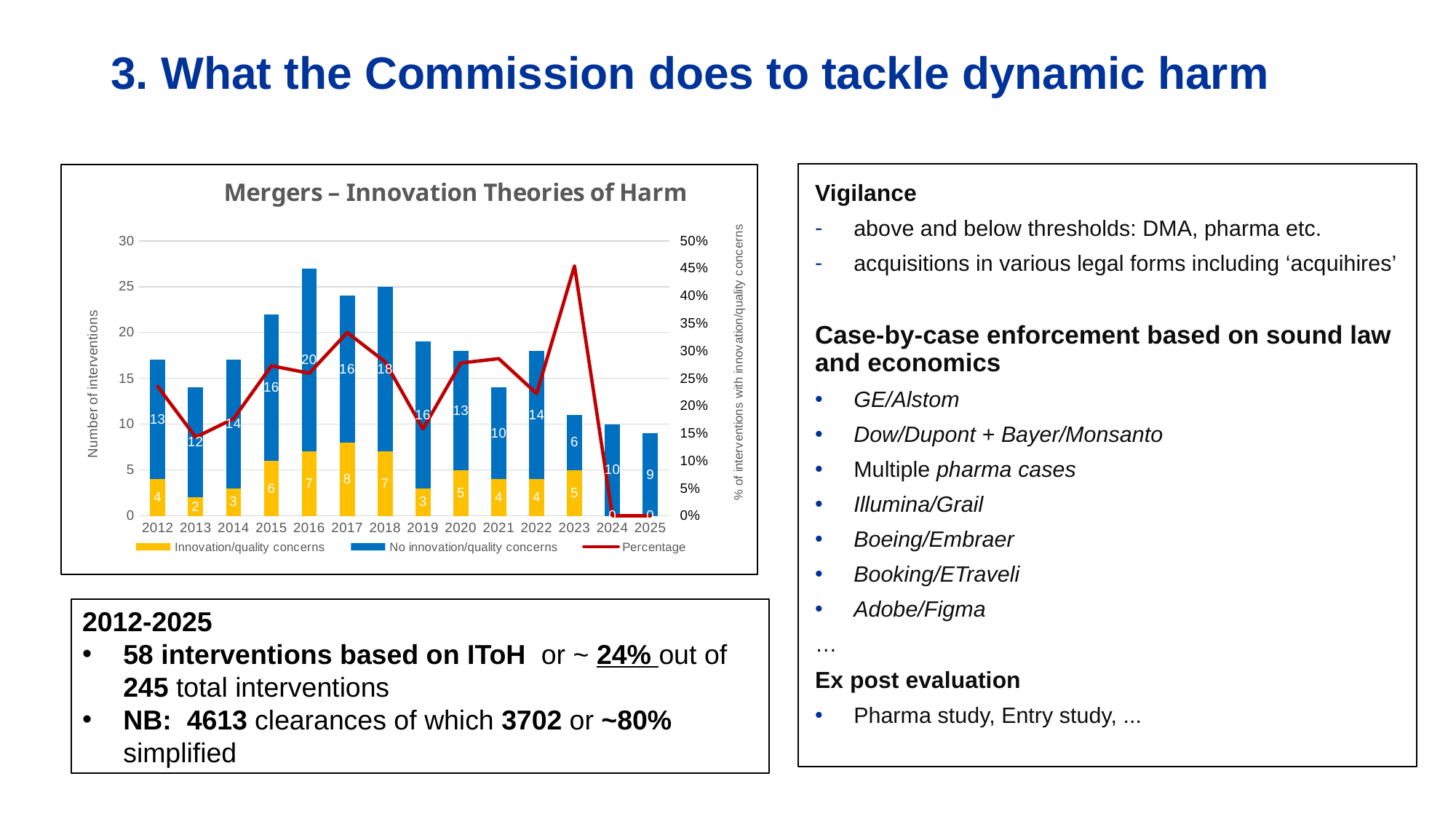
Is the Percentage value for 2023 greater or less than 40%? greater What is the total of the stacked bar for 2016? 27 Which year has the highest value for Innovation/quality concerns? 2017 What is the value for No innovation/quality concerns in 2016? 20 What kind of chart is shown on the slide? Stacked bar chart with a line What is the title of the chart on the slide? Mergers – Innovation Theories of Harm Which year has the lowest value for No innovation/quality concerns? 2023 How many series does the chart's legend list? 3 What is the difference between the No innovation/quality concerns values for 2018 and 2021? 8 What is the value for Innovation/quality concerns in 2017? 8 Which is larger: the Innovation/quality concerns value for 2015 or for 2019? 2015 How many years are shown on the x axis of the chart? 14